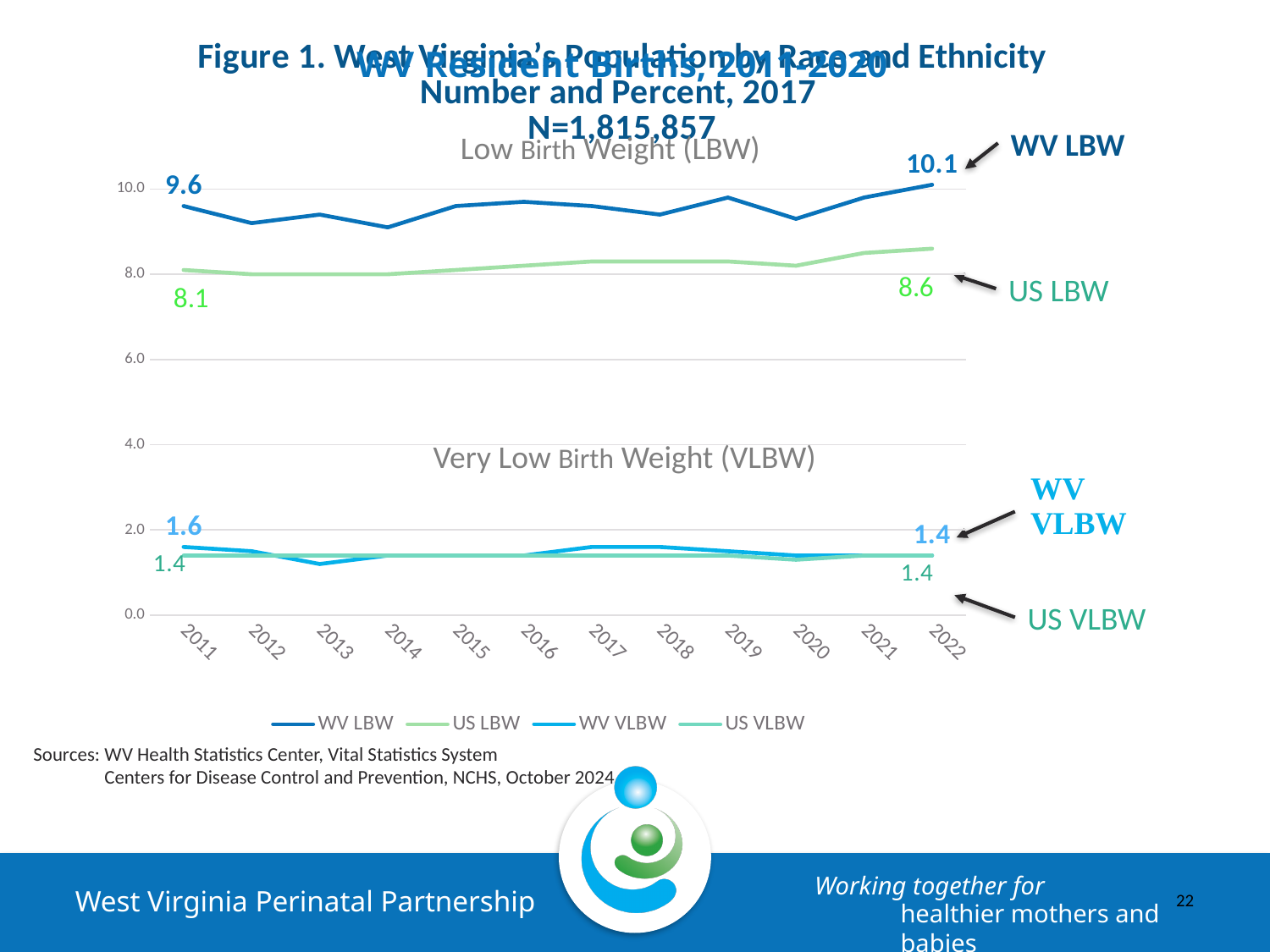
Which is larger in 2011, WV LBW or US LBW? WV LBW By how much did the WV LBW value change from 2011 to 2022? 0.5 What is the WV LBW value in 2011? 9.6 What is the difference between the WV LBW and US LBW values in 2022? 1.5 What is the WV LBW value in 2022? 10.1 What kind of chart is shown on the slide? Line chart How many years are shown on the x axis? 12 What is the WV VLBW value in 2011? 1.6 What is the US LBW value in 2022? 8.6 What is the US LBW value in 2011? 8.1 What is the US VLBW value in 2022? 1.4 How many series does the legend list? 4